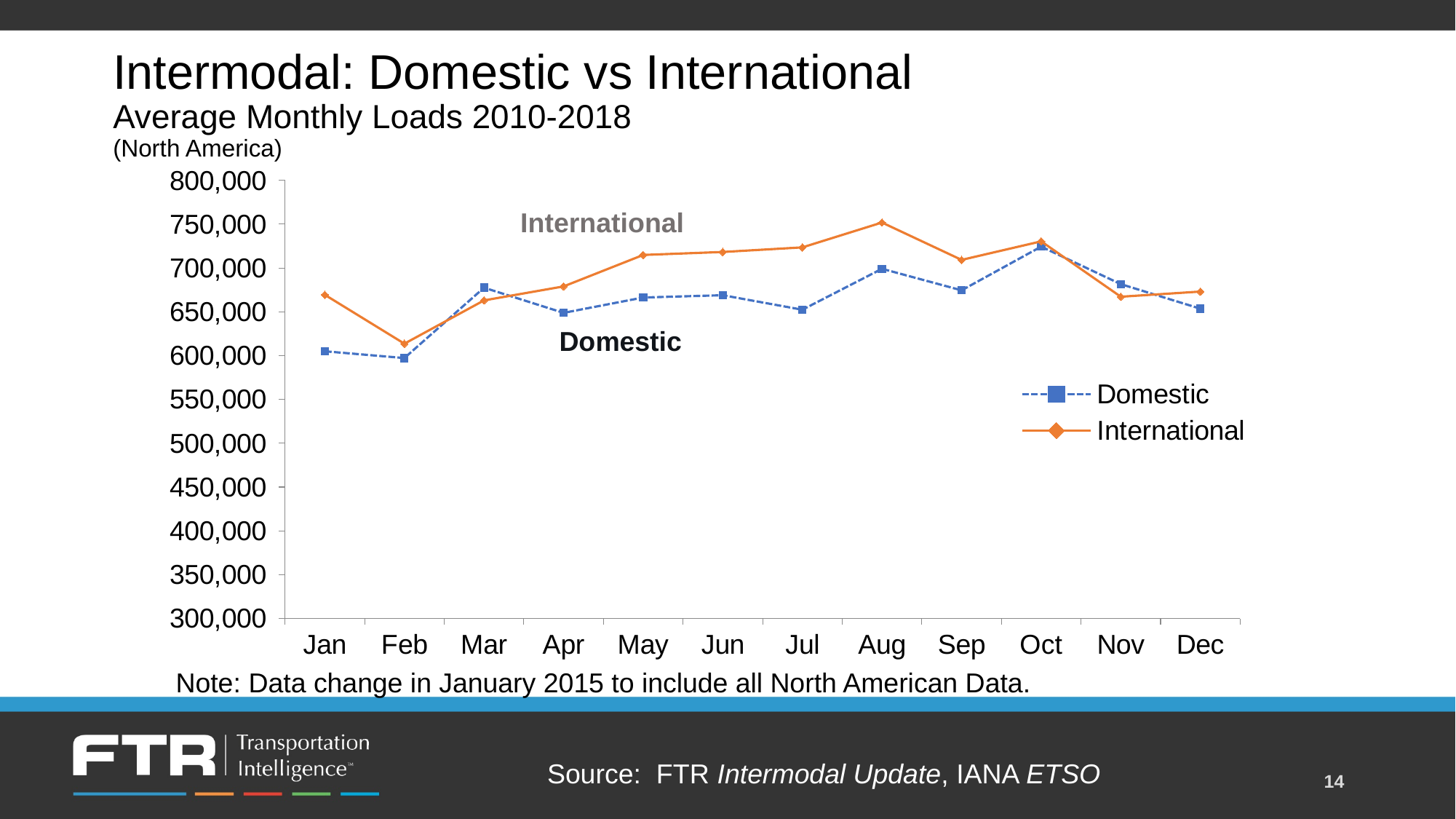
What kind of chart is shown on the slide? Line chart Is the Domestic value for Jul greater or less than 700,000? less In which month does the International series reach its highest value? Aug How many months are plotted along the x axis? 12 Is the International value for Aug greater or less than 700,000? greater In which month does the International series reach its lowest value? Feb Which series is drawn with a dashed line and square markers? Domestic How many series does the legend list? 2 Does the Domestic series rise or fall from Feb to Mar? Rise In which month does the Domestic series reach its lowest value? Feb In Aug, which series has the larger value, Domestic or International? International Is the International value for Jan greater or less than 650,000? greater